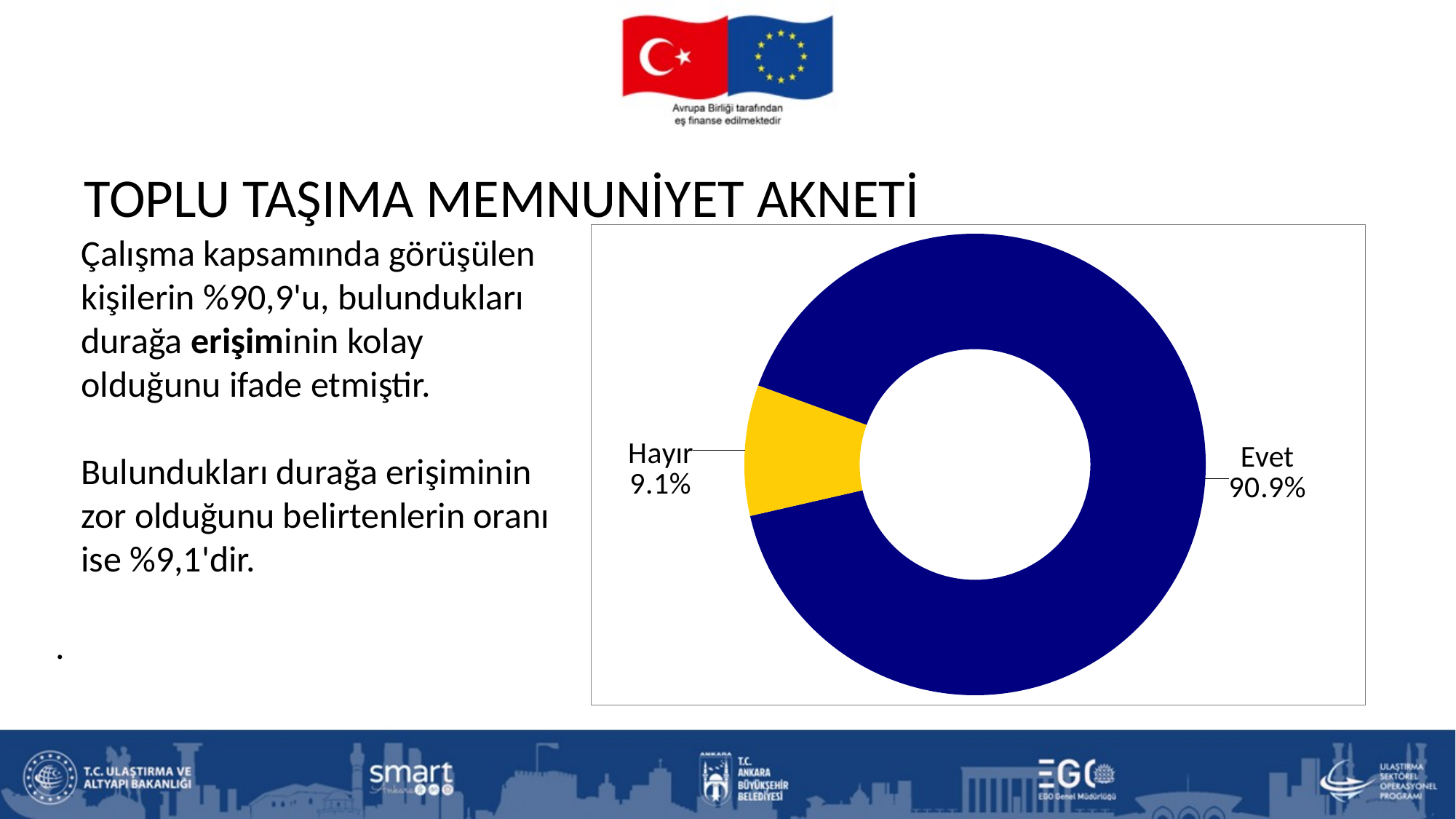
What kind of chart is shown on the slide? Doughnut (pie) chart What is the difference between the Evet and Hayır shares? 81.8% Which is larger, the share for Evet or the share for Hayır? Evet Which category has the largest share of the chart? Evet What is the value shown for Hayır? 9.1% What share of the chart does the Hayır slice represent? 9.1% What colour is the Evet slice? Dark blue What colour is the Hayır slice? Yellow How many categories are shown in the chart? 2 Which category has the smallest share of the chart? Hayır What is the value shown for Evet? 90.9%